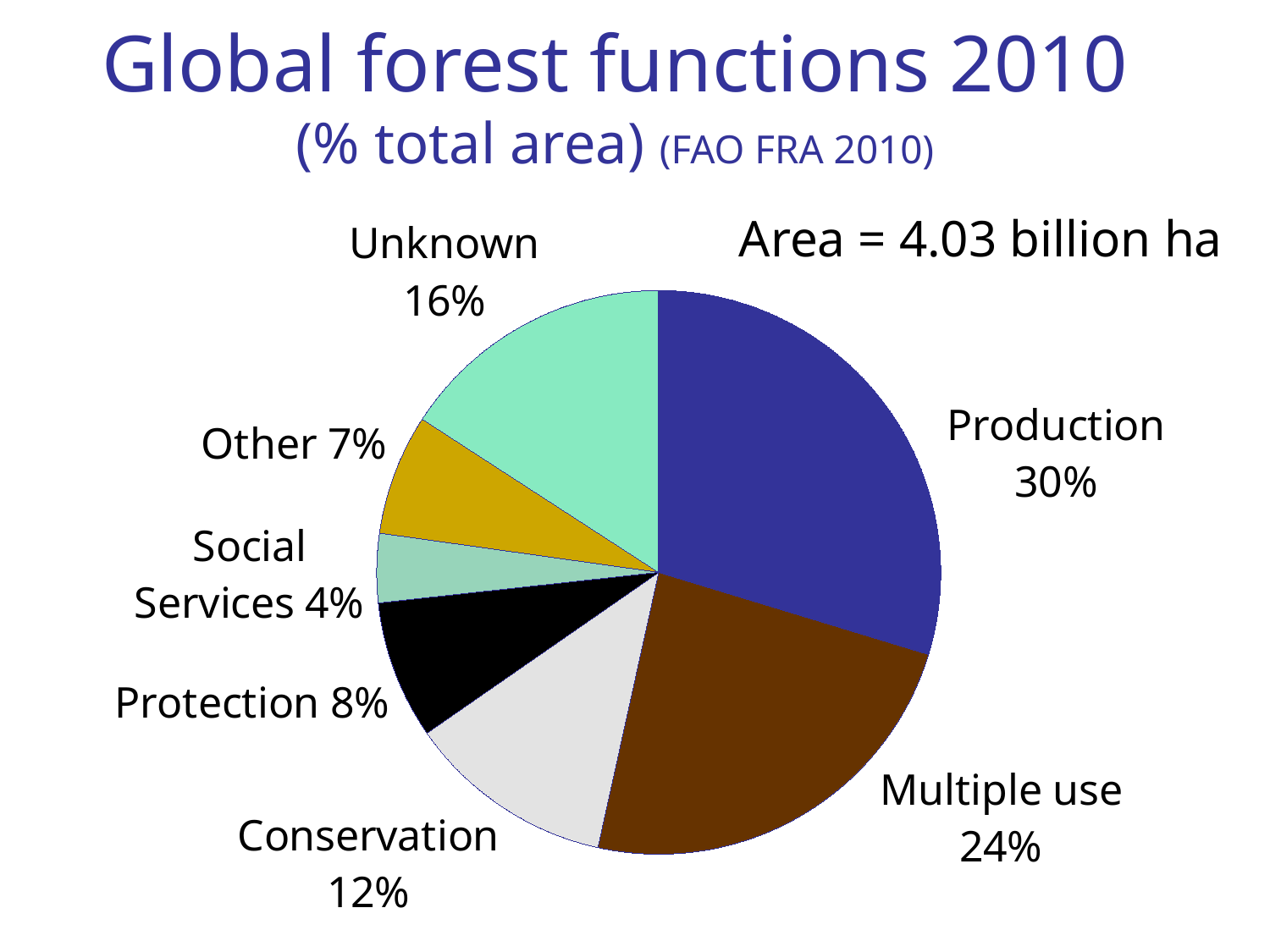
What percentage of the pie is Multiple use? 24% What kind of chart is shown on the slide? Pie chart What is the difference in percentage points between Unknown and Protection? 8 How many slices does the pie chart have? 7 What total area is stated on the slide for the pie chart? 4.03 billion ha Which forest function has the largest share of the pie? Production What share is shown for Conservation? 12% Which forest function has the smallest share of the pie? Social Services How many percentage points larger is Production than Multiple use? 6 Which is larger, the share for Other or the share for Protection? Protection What share of total forest area is labelled as Production? 30% What percentage is labelled for Social Services? 4%